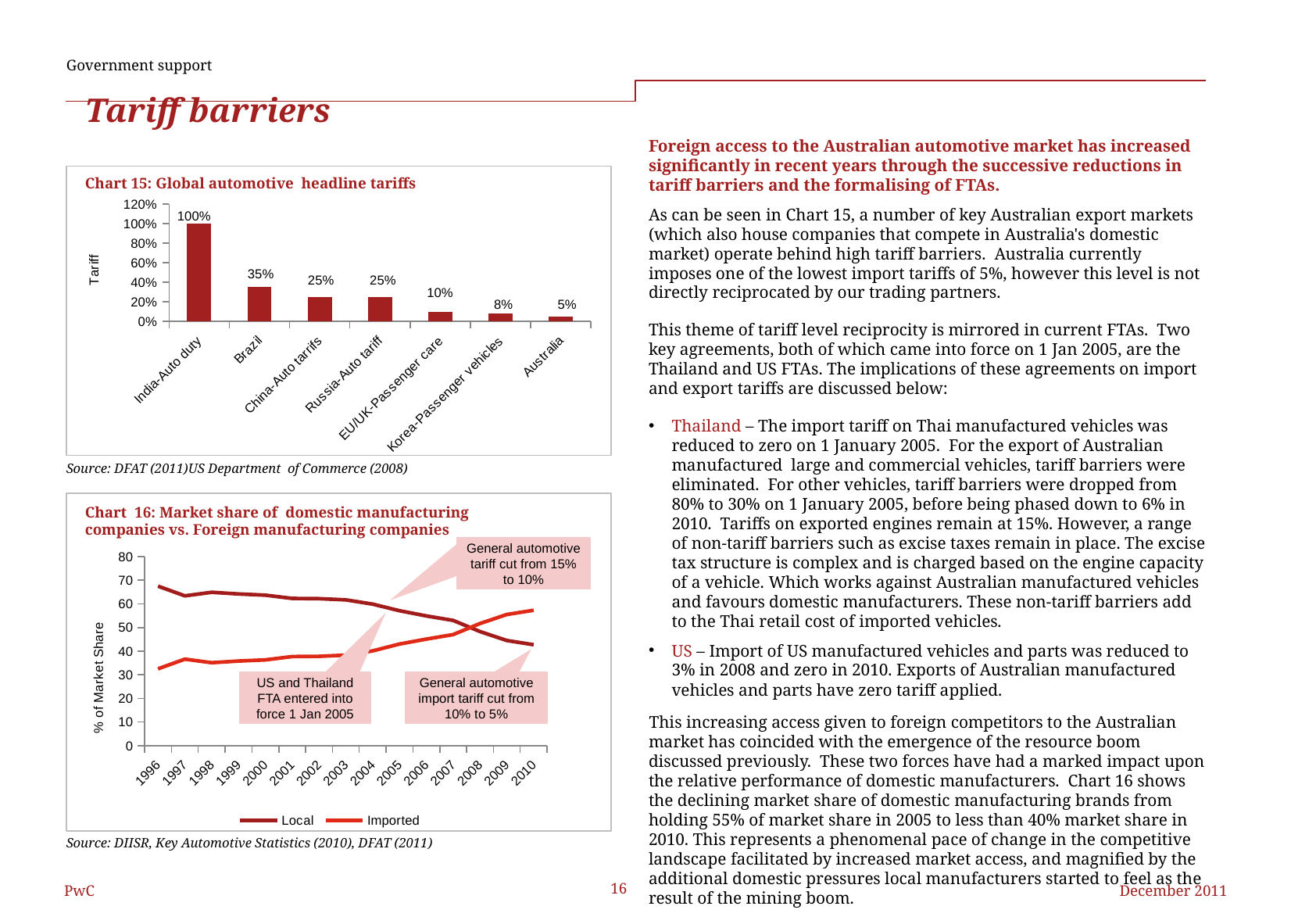
In Chart 15, which is larger, the tariff for EU/UK-Passenger care or the tariff for Australia? EU/UK-Passenger care In Chart 16, does the Local series rise or fall from 1996 to 2010? Fall In Chart 15, which category has the lowest tariff? Australia In Chart 15, what is the headline tariff for Korea-Passenger vehicles? 8% In Chart 15, what is the difference between the tariff for India-Auto duty and the tariff for Brazil? 65% In Chart 16, is the value for Imported in 2010 greater or less than 50? greater What kind of chart is Chart 15? Bar chart In Chart 15, how many categories are shown? 7 In Chart 15, what is the headline tariff for Brazil? 35% In Chart 15, which category has the highest tariff? India-Auto duty In Chart 16, how many series does the legend list? 2 In Chart 16, is the value for Local in 1996 greater or less than 60? greater